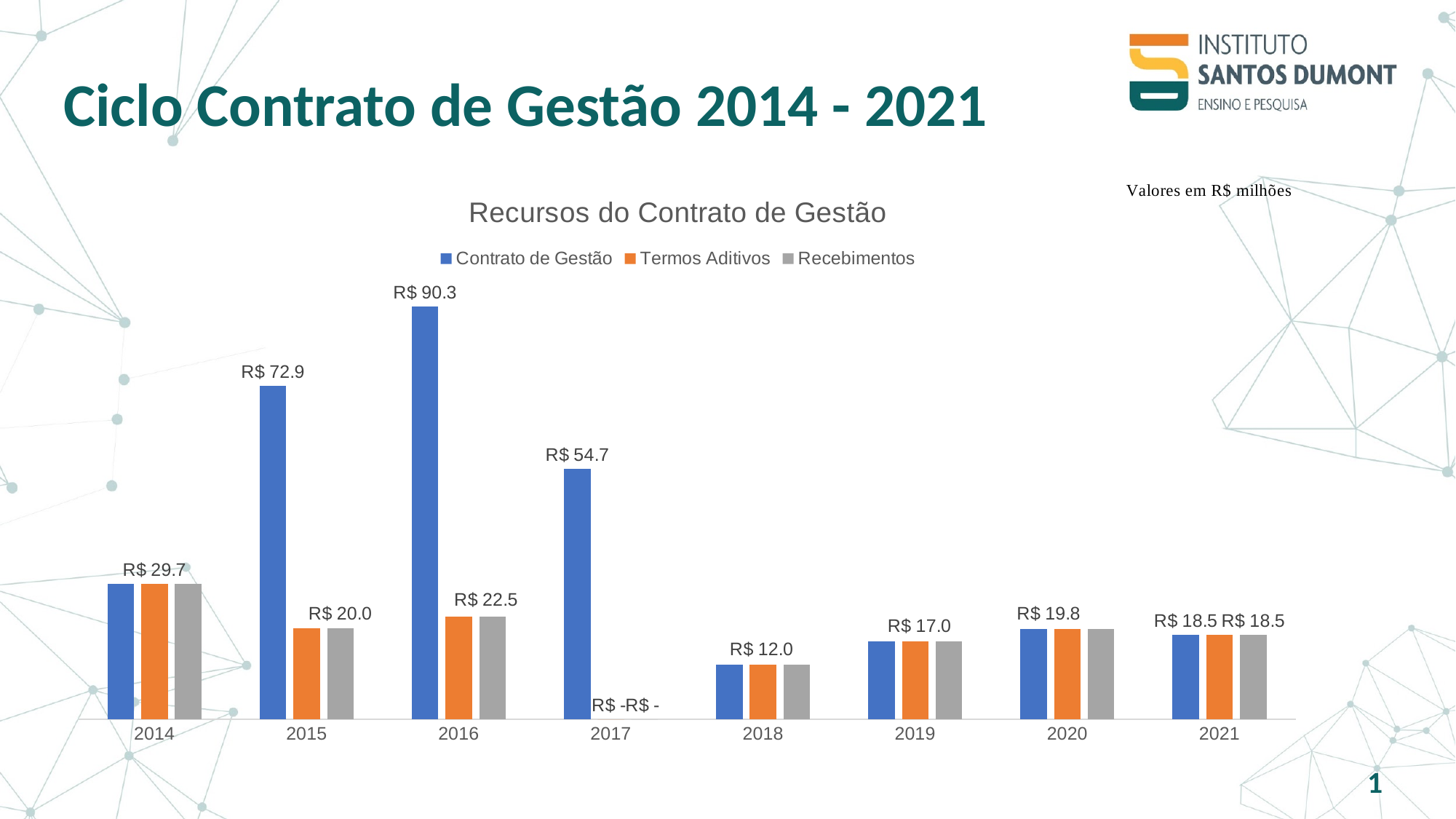
In which year is the Contrato de Gestão value highest? 2016 What is the difference between the Contrato de Gestão values for 2016 and 2015? R$ 17.4 In which year is the Contrato de Gestão value lowest? 2018 What is the value of Contrato de Gestão in 2016? R$ 90.3 How many series does the legend list? 3 What is the value of Contrato de Gestão in 2015? R$ 72.9 What is the value of Contrato de Gestão in 2017? R$ 54.7 How many years are shown on the x axis of the chart? 8 What is the title of the chart? Recursos do Contrato de Gestão Which is larger in 2015, Contrato de Gestão or Termos Aditivos? Contrato de Gestão What is the value of Termos Aditivos in 2016? R$ 22.5 What type of chart is shown on the slide? bar chart